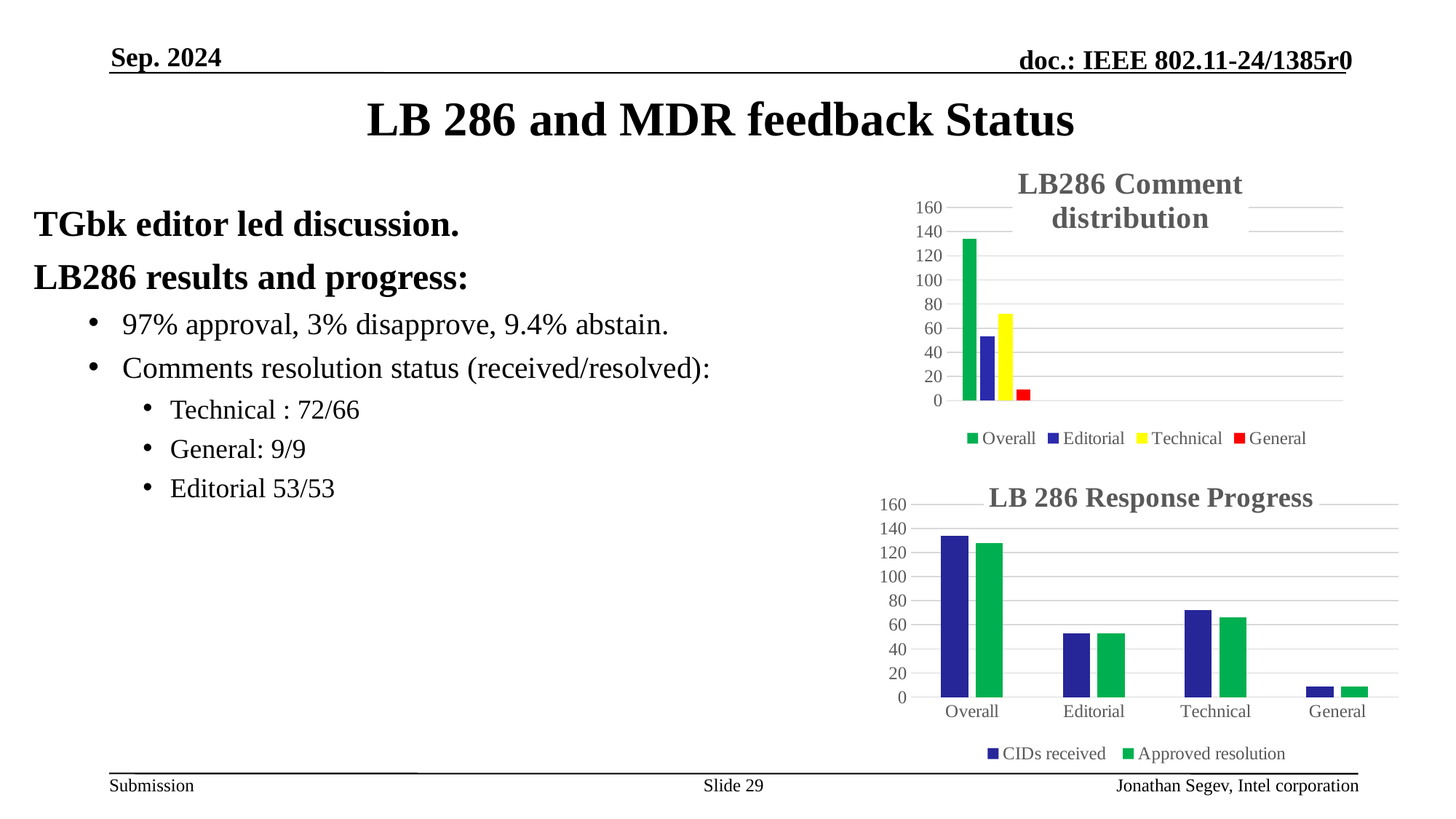
In the "LB 286 Response Progress" chart, which is larger for Technical: CIDs received or Approved resolution? CIDs received In the "LB286 Comment distribution" chart, is the value for Technical greater or less than 60? greater How many categories are shown on the x axis of the "LB 286 Response Progress" chart? 4 In the "LB286 Comment distribution" chart, which series has the tallest bar? Overall In the "LB286 Comment distribution" chart, which series has the shortest bar? General In the "LB286 Comment distribution" chart, which colour is used for the Technical series? yellow How many series does the legend of the "LB286 Comment distribution" chart list? 4 How many series does the legend of the "LB 286 Response Progress" chart list? 2 In the "LB286 Comment distribution" chart, is the value for Overall greater or less than 120? greater What kind of chart is the "LB286 Comment distribution" chart? bar chart In the "LB 286 Response Progress" chart, is the Approved resolution value for General greater or less than 20? less